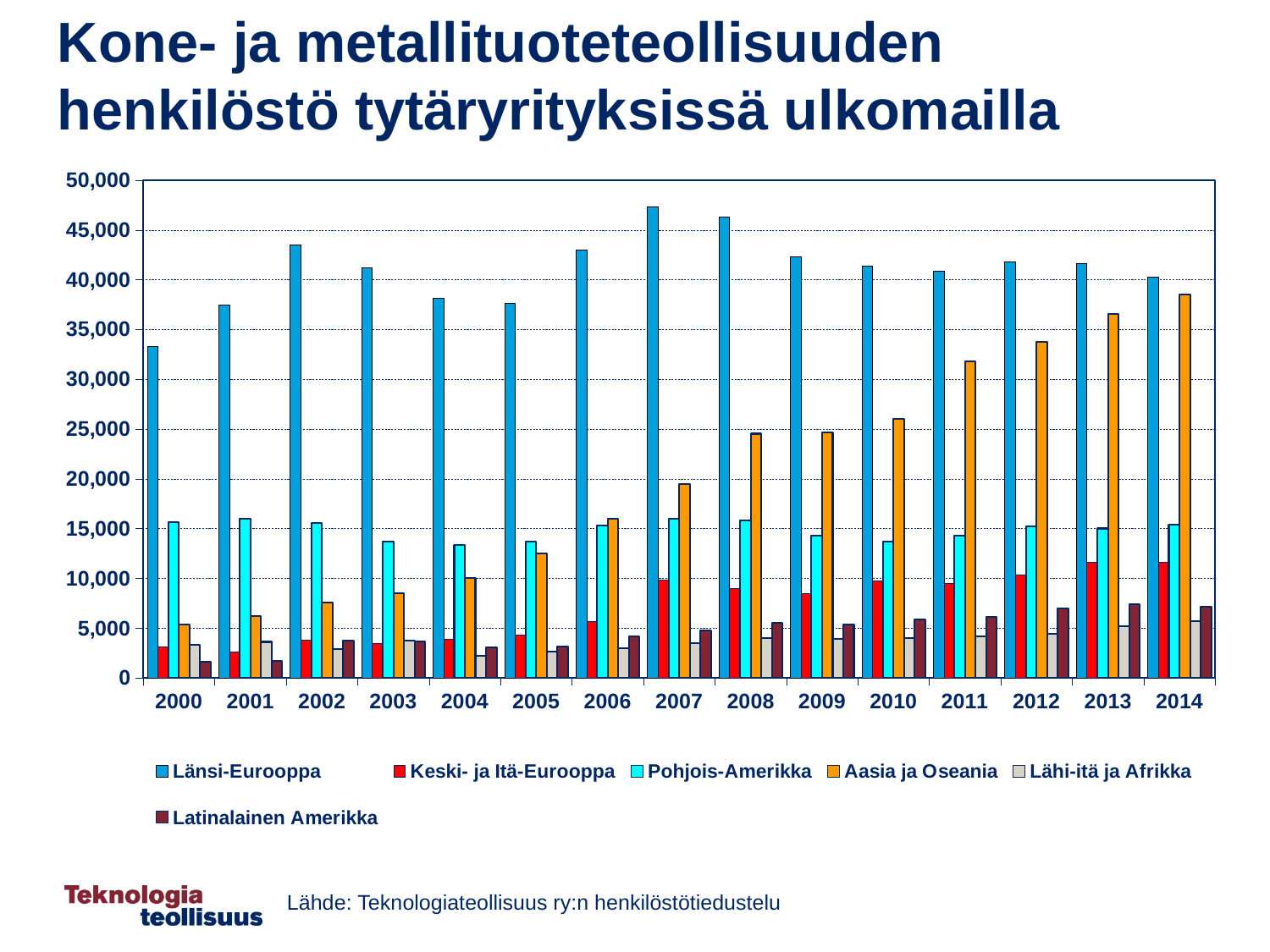
How many years are shown on the x axis? 15 In 2000, which is larger: Pohjois-Amerikka or Aasia ja Oseania? Pohjois-Amerikka In which year is the value for Länsi-Eurooppa highest? 2007 How many series does the legend list? 6 Is the value for Aasia ja Oseania in 2014 greater or less than 35,000? greater In which year is the value for Länsi-Eurooppa lowest? 2000 Is the value for Latinalainen Amerikka in 2000 greater or less than 5,000? less Is the value for Keski- ja Itä-Eurooppa in 2014 greater or less than 10,000? greater Do the values for Aasia ja Oseania generally rise or fall from 2000 to 2014? rise Which series has the highest value in 2012? Länsi-Eurooppa What kind of chart is shown on the slide? bar chart